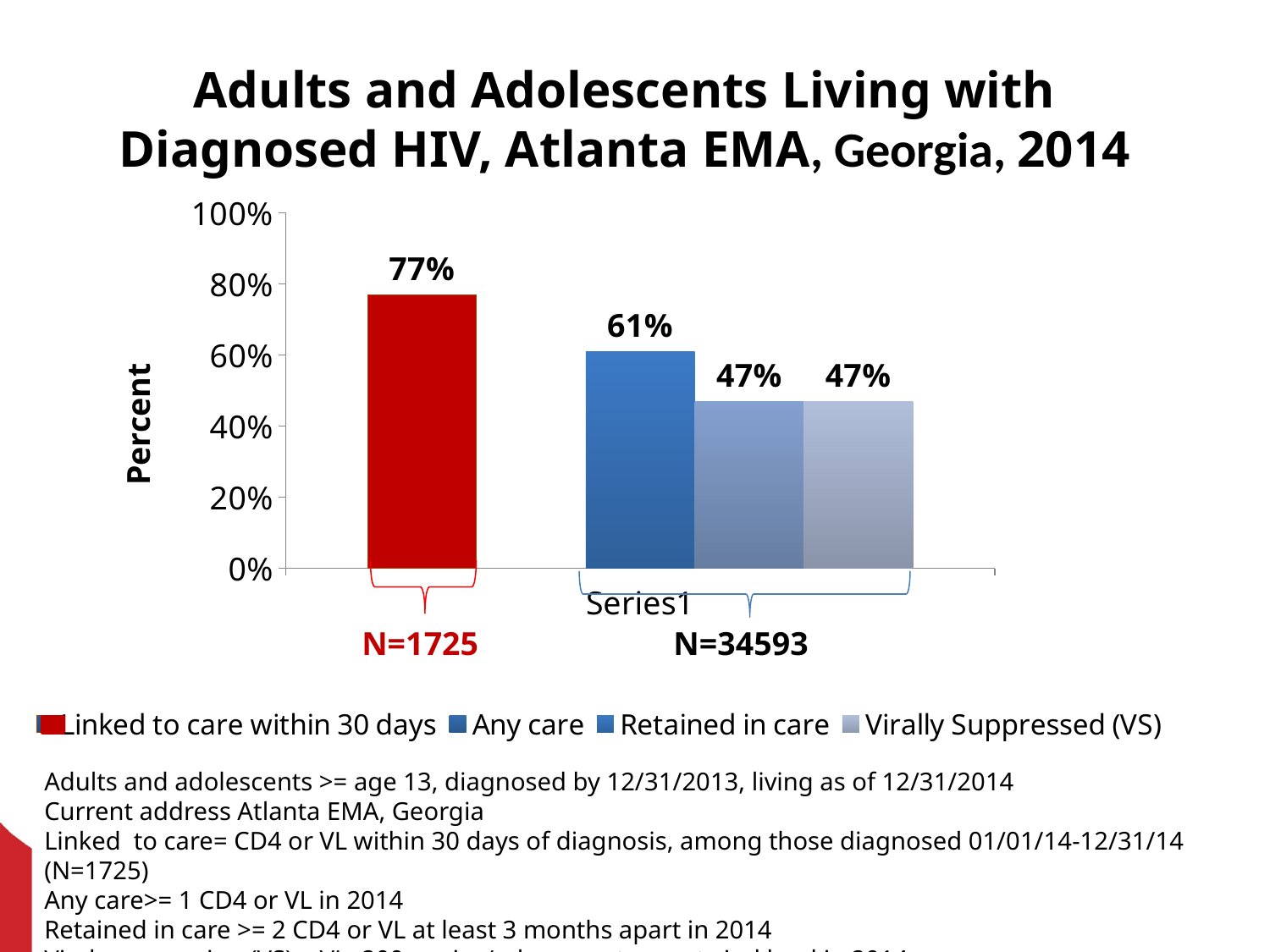
What is the value for Any care? 61% What is the difference between the Any care value and the Retained in care value? 14% What is the value for Virally Suppressed (VS)? 47% What is the value for Linked to care within 30 days? 77% What is the difference between the Linked to care within 30 days value and the Any care value? 16% Which series has the highest value? Linked to care within 30 days Is the value for Linked to care within 30 days greater or less than 80%? less What kind of chart is shown on the slide? bar chart What is the label on the vertical axis? Percent What is the value for Retained in care? 47% Which is larger, the value for Any care or the value for Retained in care? Any care How many series does the legend list? 4